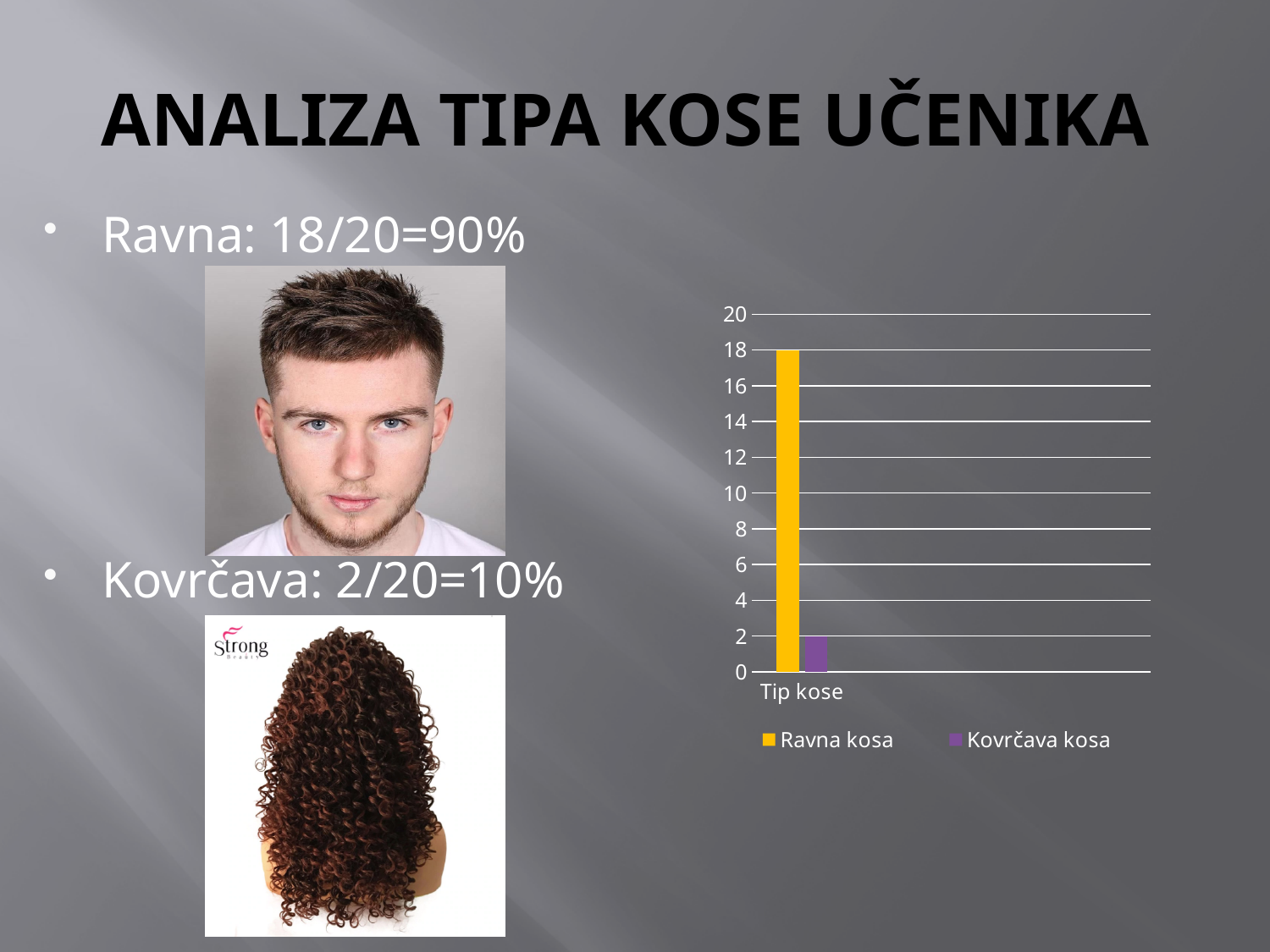
Is the value for Kovrčava kosa greater or less than 4? less What colour is the Ravna kosa bar in the chart? yellow Which series has the highest value in the chart? Ravna kosa What is the value of the Ravna kosa bar in the chart? 18 Is the value for Ravna kosa greater or less than 10? greater Which series has the taller bar in the chart, Ravna kosa or Kovrčava kosa? Ravna kosa What is the difference between the Ravna kosa and Kovrčava kosa values in the chart? 16 How many series does the chart legend list? 2 What kind of chart is shown on the slide? bar chart Which series has the lowest value in the chart? Kovrčava kosa What is the value of the Kovrčava kosa bar in the chart? 2 What is the category label shown on the x axis of the chart? Tip kose